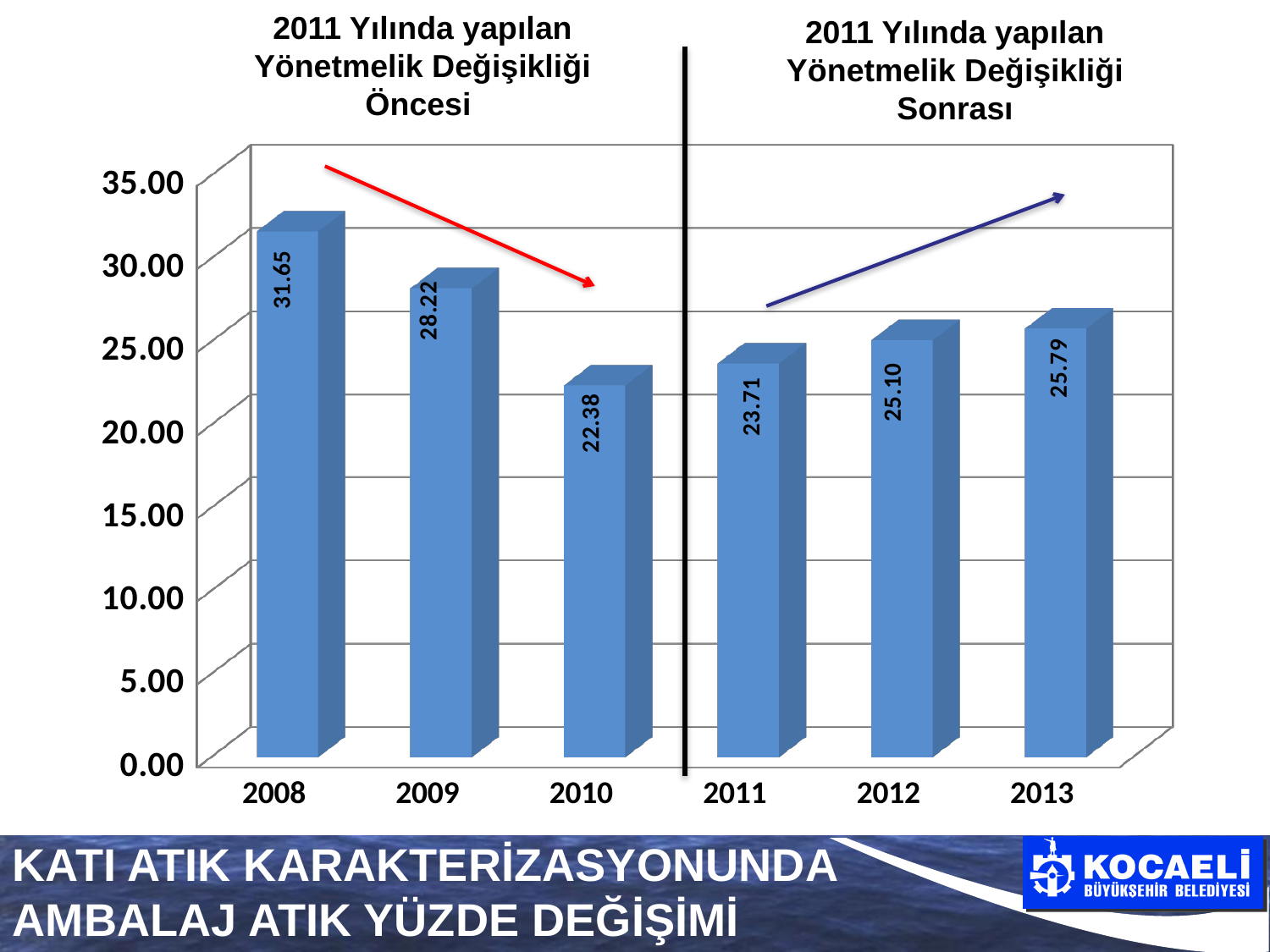
What is the difference between the values for 2008 and 2010? 9.27 What is the value for 2010? 22.38 Which year has the highest value? 2008 What is the value for 2008? 31.65 Which is larger, the value for 2009 or the value for 2012? 2009 What kind of chart is shown on the slide? bar chart Is the value for 2011 greater or less than 25.00? less What is the difference between the values for 2013 and 2011? 2.08 How many years are shown on the x axis? 6 Which year has the lowest value? 2010 What is the value for 2013? 25.79 Do the values rise or fall from 2011 to 2013? rise